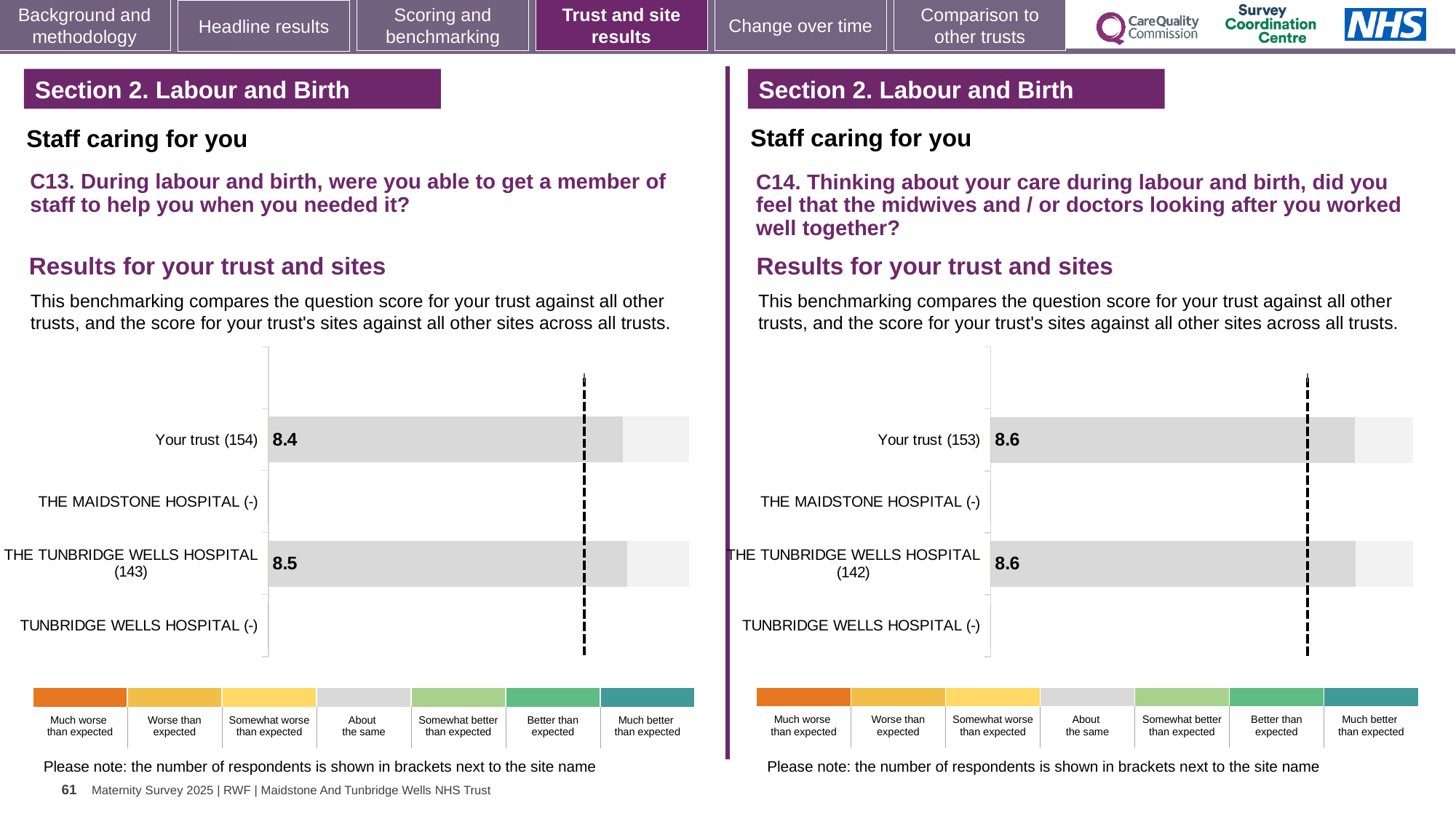
How many site/trust categories are listed on the C13 chart (left)? 4 On the C13 chart (left), how many respondents are shown in brackets for Your trust? 154 On the C13 chart (left), what is the score for The Tunbridge Wells Hospital? 8.5 On the C14 chart (right), what is the difference between the score for Your trust and the score for The Tunbridge Wells Hospital? 0 On the C13 chart (left), which category has the highest score among those with a plotted value? The Tunbridge Wells Hospital On the C13 chart (left), which has the higher score: Your trust or The Tunbridge Wells Hospital? The Tunbridge Wells Hospital On the C14 chart (right), what is the score for Your trust? 8.6 On the C13 chart (left), what is the difference between the score for The Tunbridge Wells Hospital and the score for Your trust? 0.1 On the C14 chart (right), what is the score for The Tunbridge Wells Hospital? 8.6 On the C13 chart (left), what is the score for Your trust? 8.4 What type of chart is used on the C14 chart (right)? Bar chart On the C14 chart (right), how many respondents are shown in brackets for The Tunbridge Wells Hospital? 142